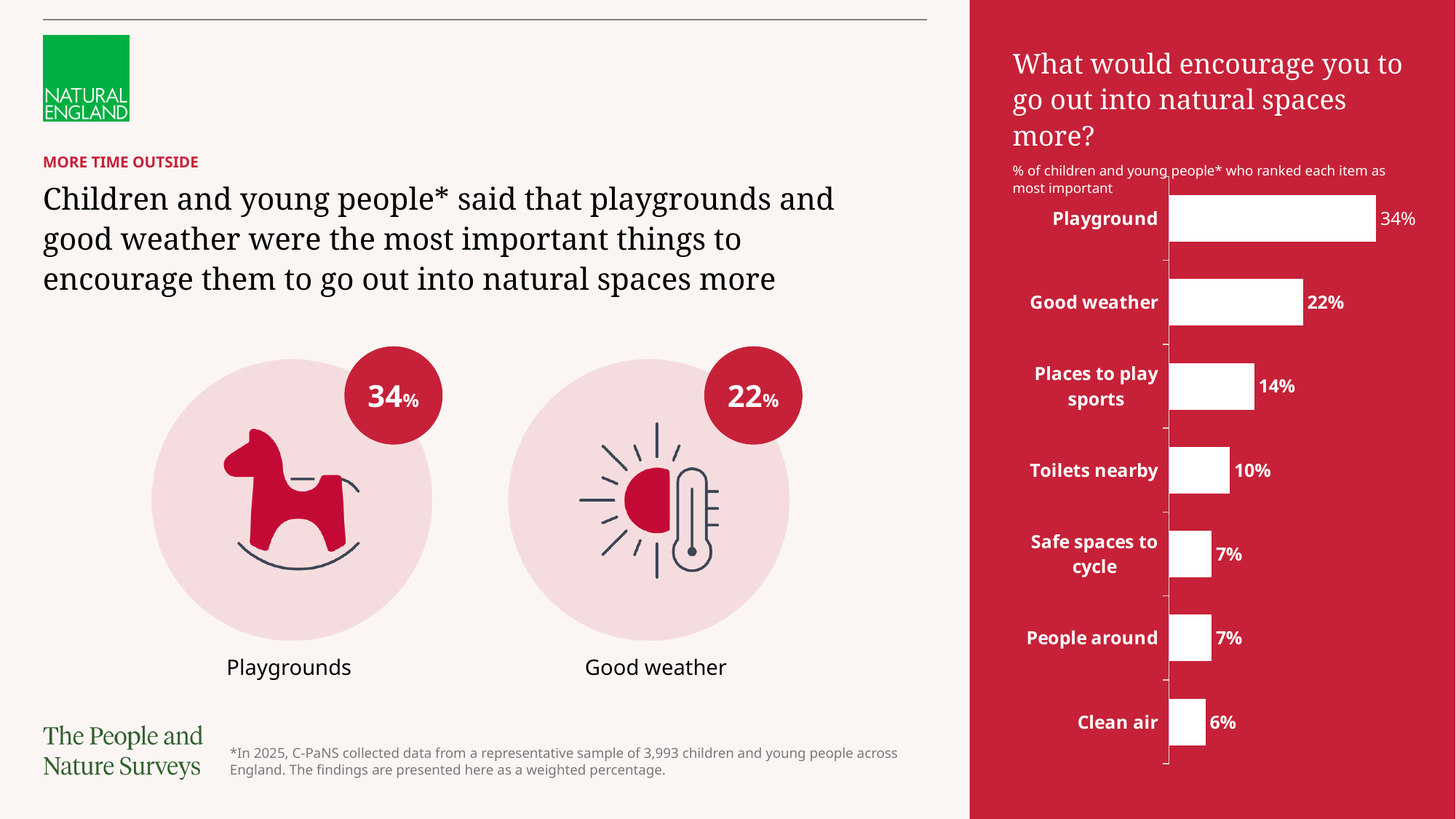
Do the values rise or fall going down the chart from Playground to Clean air? Fall Which item has the highest percentage in the chart? Playground What is the value shown for Toilets nearby? 10% What is the difference in percentage points between Places to play sports and Clean air? 8 How many items are listed in the bar chart? 7 What kind of chart is shown on the right of the slide? Bar chart Which is larger, the value for Good weather or the value for Toilets nearby? Good weather What is the title of the chart on the right of the slide? What would encourage you to go out into natural spaces more? Which item has the lowest percentage in the chart? Clean air What is the difference in percentage points between Playground and Good weather? 12 What is the value shown for Places to play sports? 14% What percentage of children and young people ranked Playground as most important? 34%